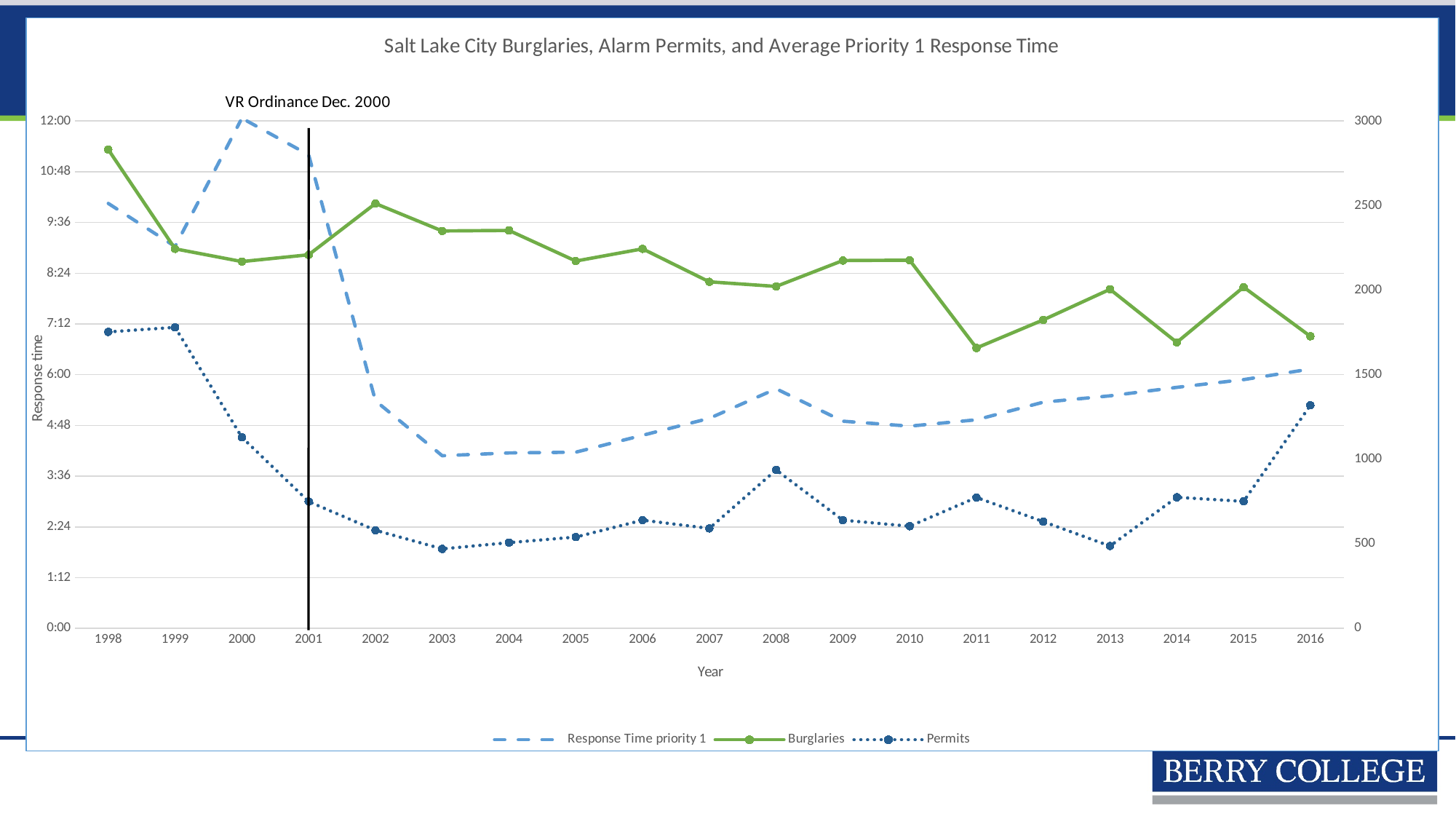
What does the annotation next to the vertical black line say? VR Ordinance Dec. 2000 In which year is the Response Time priority 1 series at its highest? 2000 Is the Burglaries value for 1998 greater or less than 2500? greater Is the Burglaries value for 2011 greater or less than 2000? less Which year has more Burglaries, 2002 or 2016? 2002 How many series does the legend list? 3 What is the title of the chart? Salt Lake City Burglaries, Alarm Permits, and Average Priority 1 Response Time What kind of chart is shown on the slide? Line chart In which year is the Burglaries series at its highest? 1998 Is the Permits value for 2016 greater or less than 1000? greater In which year is the Permits series at its highest? 1999 How many years are plotted along the x axis? 19